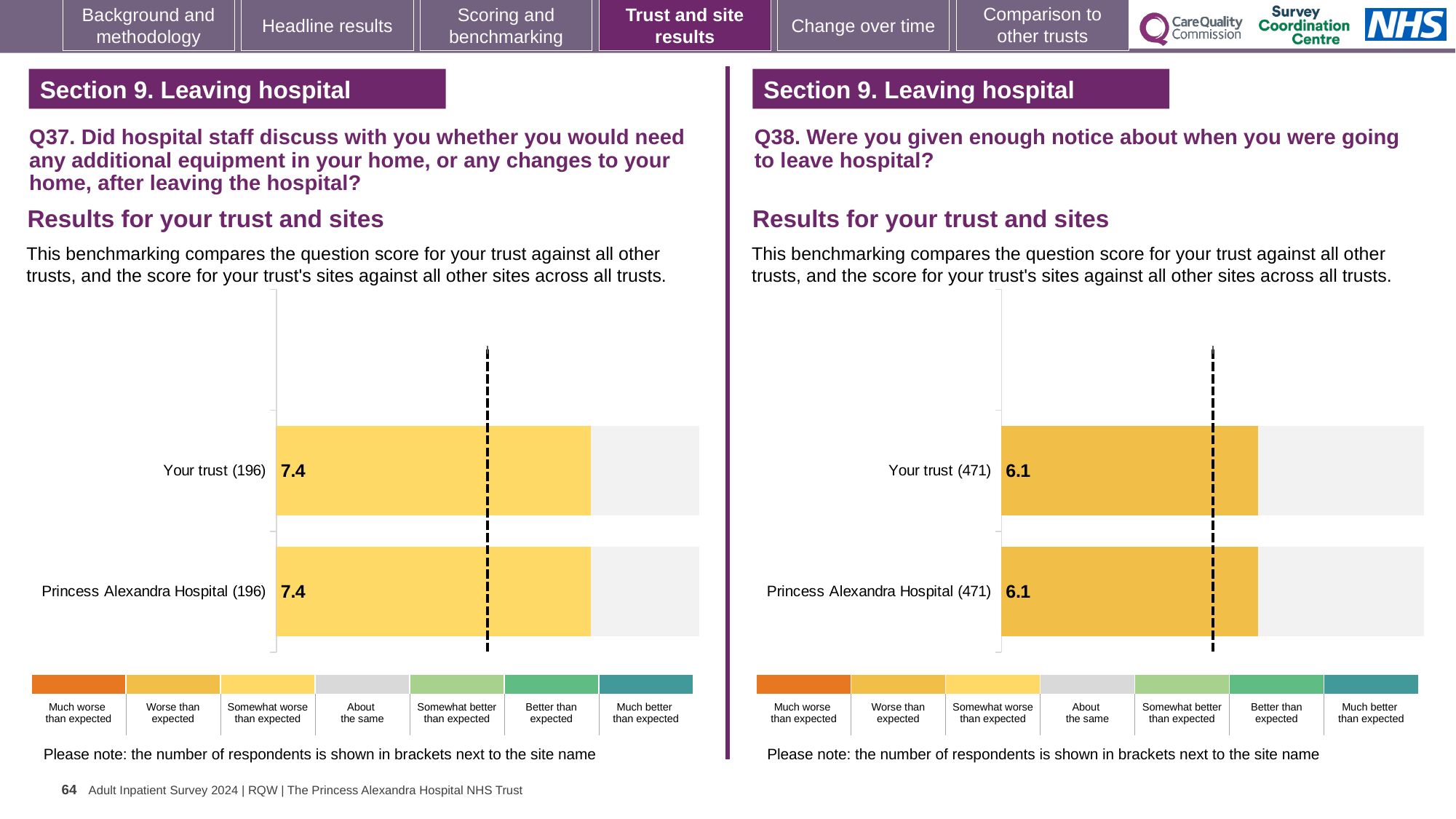
In the Q37 chart on the left, how many respondents are shown in brackets next to Your trust? 196 In the Q38 chart on the right, what is the score for Your trust? 6.1 How many bars are plotted in the Q37 chart on the left? 2 How many bars are plotted in the Q38 chart on the right? 2 In the Q38 chart on the right, what is the score for Princess Alexandra Hospital? 6.1 In the Q37 chart on the left, what is the score for Your trust? 7.4 What kind of chart is used for the Q38 results on the right? Bar chart Which benchmarking category does the bar colour for Your trust in the Q38 chart on the right correspond to, according to the legend? Worse than expected In the Q37 chart on the left, what is the score for Princess Alexandra Hospital? 7.4 In the Q38 chart on the right, what is the difference between the score for Your trust and the score for Princess Alexandra Hospital? 0.0 In the Q38 chart on the right, how many respondents are shown in brackets next to Princess Alexandra Hospital? 471 In the Q37 chart on the left, what is the difference between the score for Your trust and the score for Princess Alexandra Hospital? 0.0